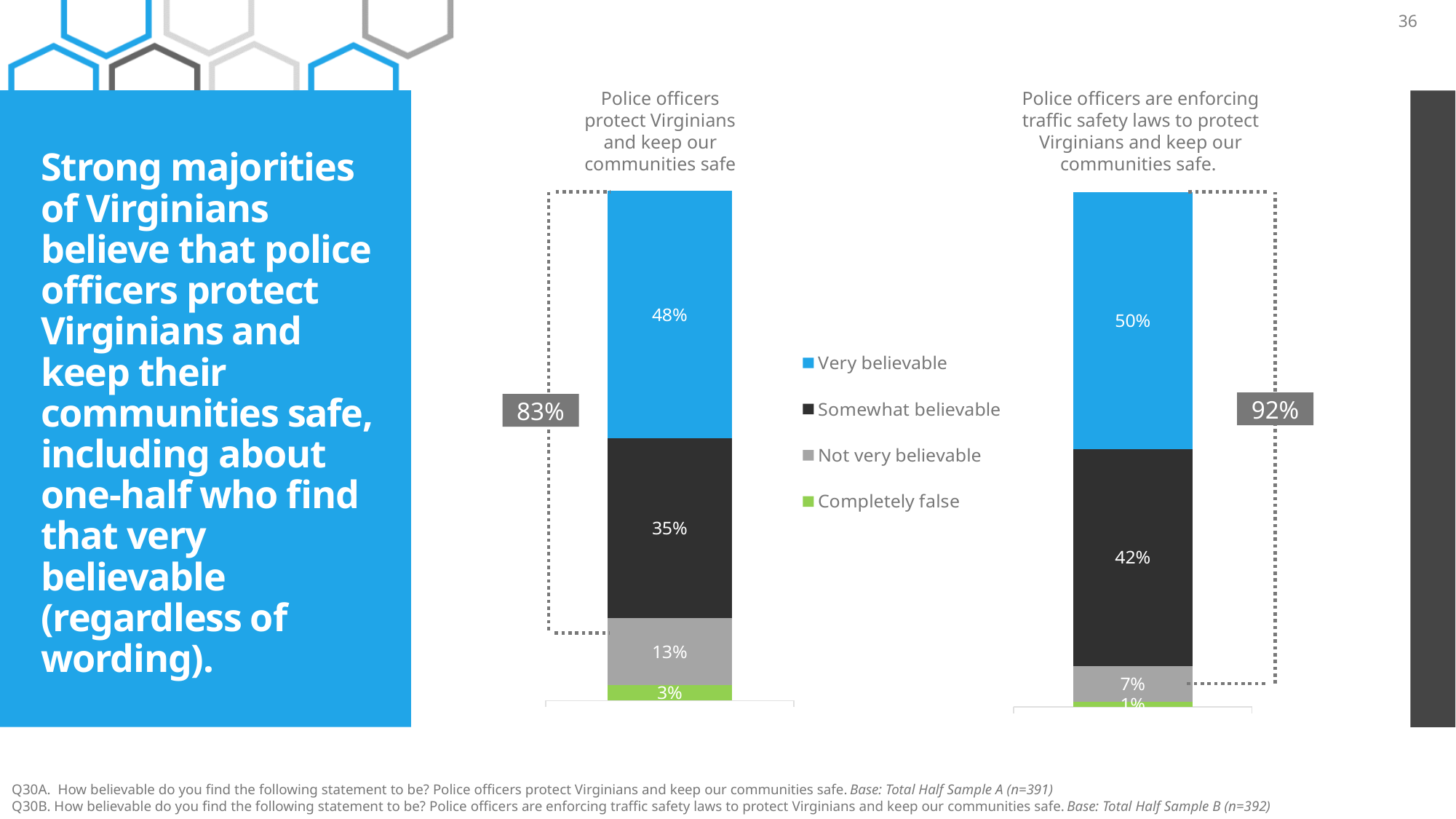
Which chart has the larger 'Somewhat believable' percentage, the left chart or the right chart? The right chart What combined percentage is shown in the callout for the left chart? 83% In the right chart, what percentage found the statement not very believable? 7% In the right chart, which response category has the smallest share? Completely false What combined percentage (very believable plus somewhat believable) is shown in the callout for the right chart? 92% In the left chart, which response category has the largest share? Very believable How many series does the legend list? 4 What is the difference between the 'Very believable' percentages in the right chart and the left chart? 2 percentage points In the left chart, what percentage said the statement was completely false? 3% What type of chart is used on this slide? Stacked bar chart In the right chart (Police officers are enforcing traffic safety laws), what percentage found the statement somewhat believable? 42% In the left chart (Police officers protect Virginians and keep our communities safe), what percentage found the statement very believable? 48%